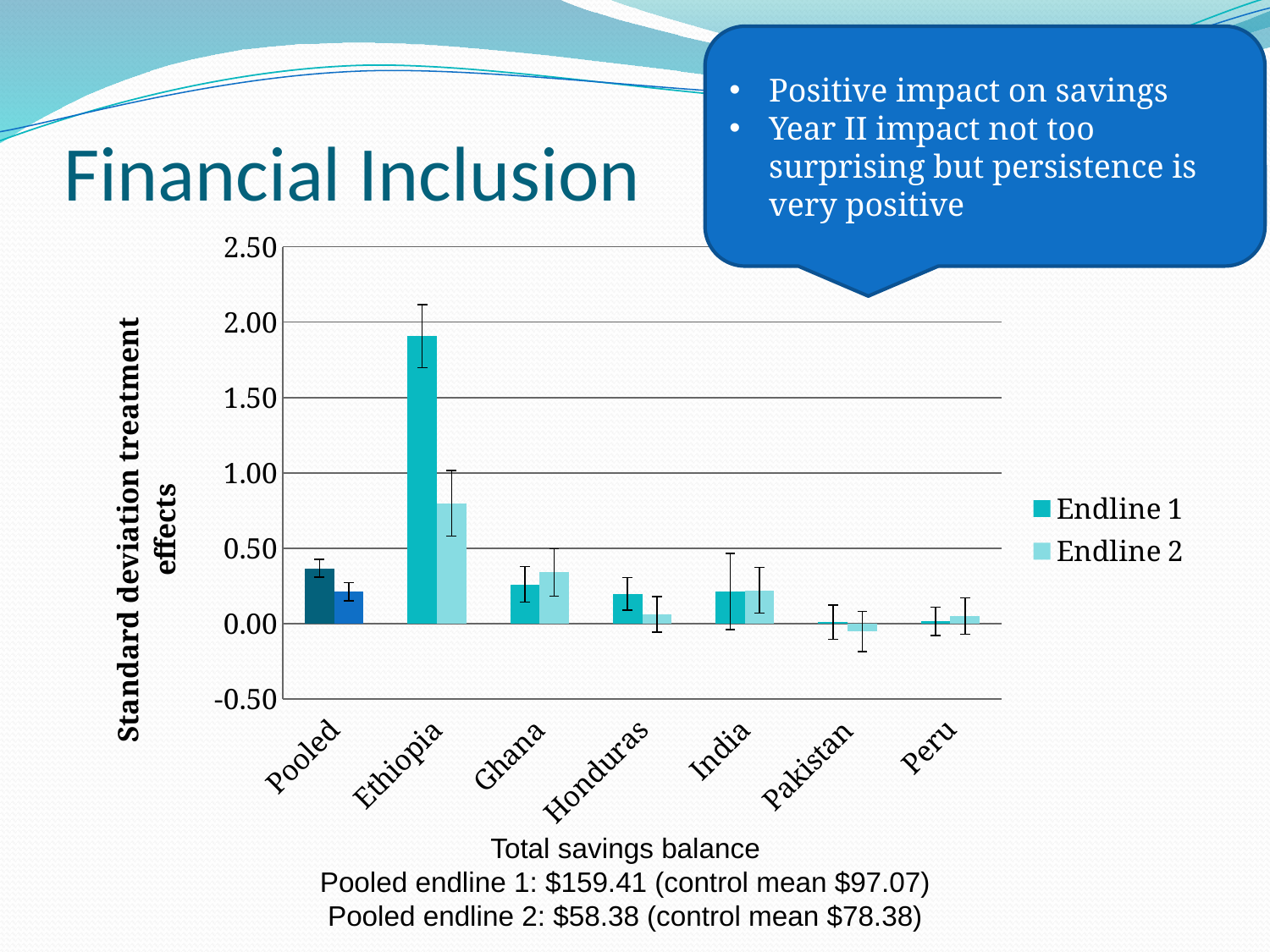
For Pooled, which is larger: the Endline 1 value or the Endline 2 value? Endline 1 How many series does the chart's legend list? 2 What are the two series named in the chart's legend? Endline 1 and Endline 2 What is the label on the vertical axis of the chart? Standard deviation treatment effects Which category has the highest Endline 2 value? Ethiopia For Ethiopia, which is larger: the Endline 1 value or the Endline 2 value? Endline 1 What kind of chart is shown on the slide? bar chart How many categories are shown on the x axis of the chart? 7 Is the Endline 1 value for Pooled greater or less than 0.50? less Is the Endline 2 value for Ethiopia greater or less than 1.00? less Is the Endline 1 value for Ethiopia greater or less than 1.50? greater Which category has the highest Endline 1 value? Ethiopia